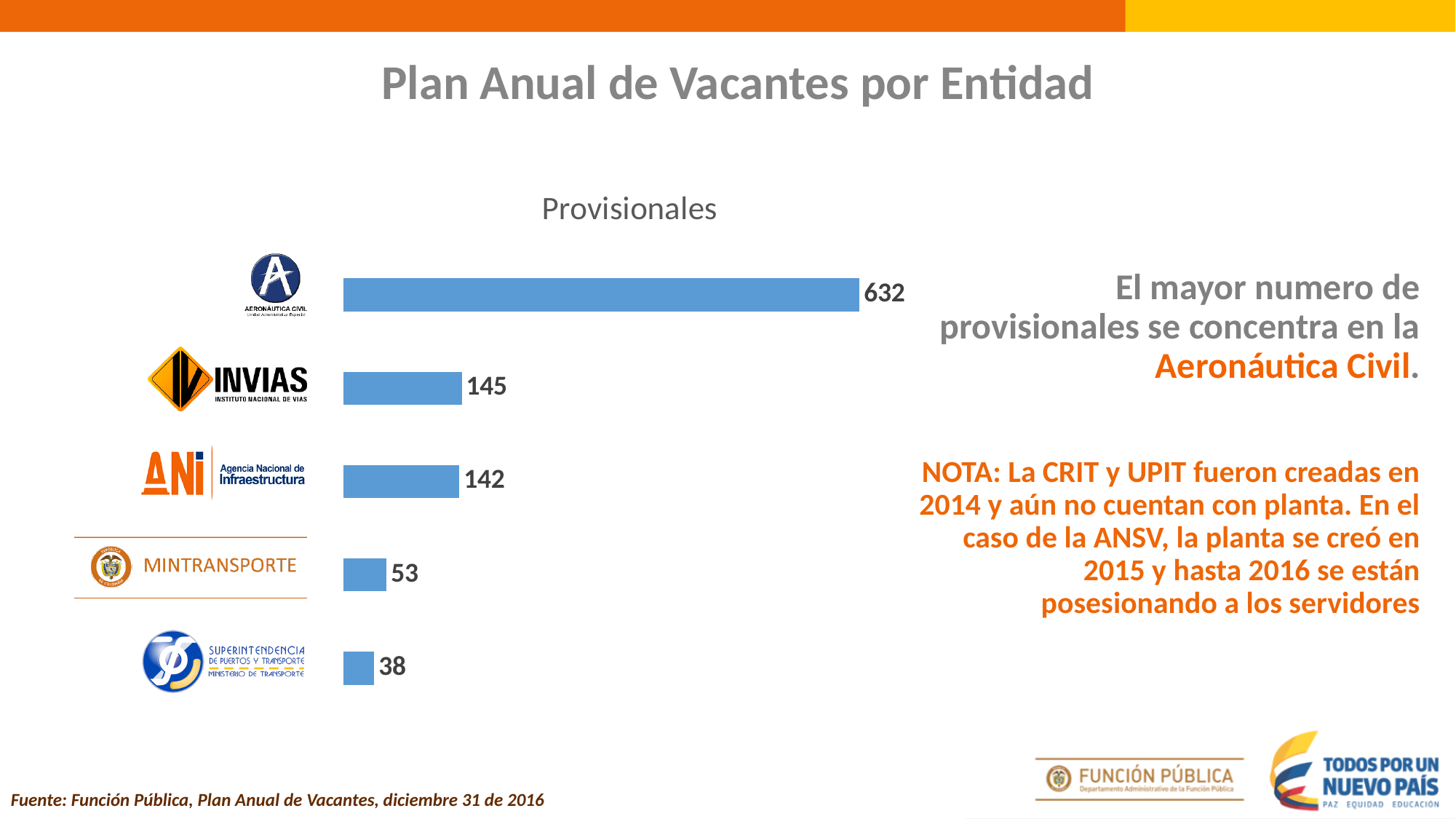
Which entity has the highest number of provisionales? Aeronáutica Civil How many entities are shown in the Provisionales chart? 5 Which has a larger value, INVIAS or Mintransporte? INVIAS Which entity has the lowest number of provisionales? Superintendencia de Puertos y Transporte What is the value for Aeronáutica Civil in the Provisionales chart? 632 What is the value for ANI (Agencia Nacional de Infraestructura) in the Provisionales chart? 142 What is the value for Mintransporte in the Provisionales chart? 53 What is the difference between the values for Aeronáutica Civil and INVIAS? 487 What is the value for the Superintendencia de Puertos y Transporte in the Provisionales chart? 38 What is the value for INVIAS in the Provisionales chart? 145 What is the difference between the values for Mintransporte and the Superintendencia de Puertos y Transporte? 15 What type of chart is used to show the provisionales by entity? Bar chart